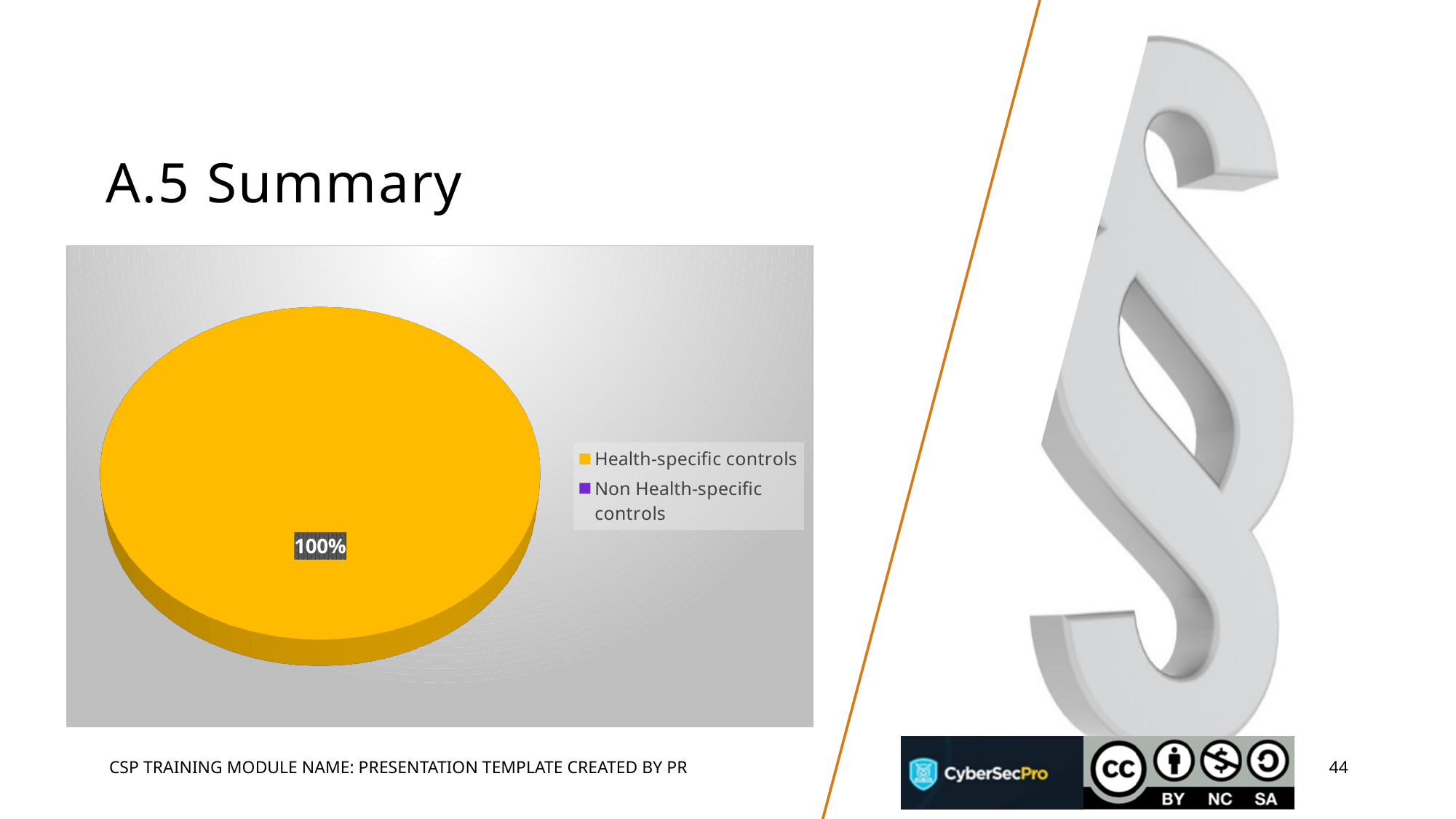
Which is larger: the share for Health-specific controls or the share for Non Health-specific controls? Health-specific controls Which category has the smallest share of the pie? Non Health-specific controls What kind of chart is shown on the slide? pie chart What colour is the Health-specific controls slice? yellow/orange What is the only data label printed on the pie chart? 100% Which category makes up the largest share of the pie? Health-specific controls How many entries does the chart legend list? 2 What colour does the legend assign to Non Health-specific controls? purple What share of the pie does the Health-specific controls slice represent? 100% Is the share for Health-specific controls greater or less than 50%? greater